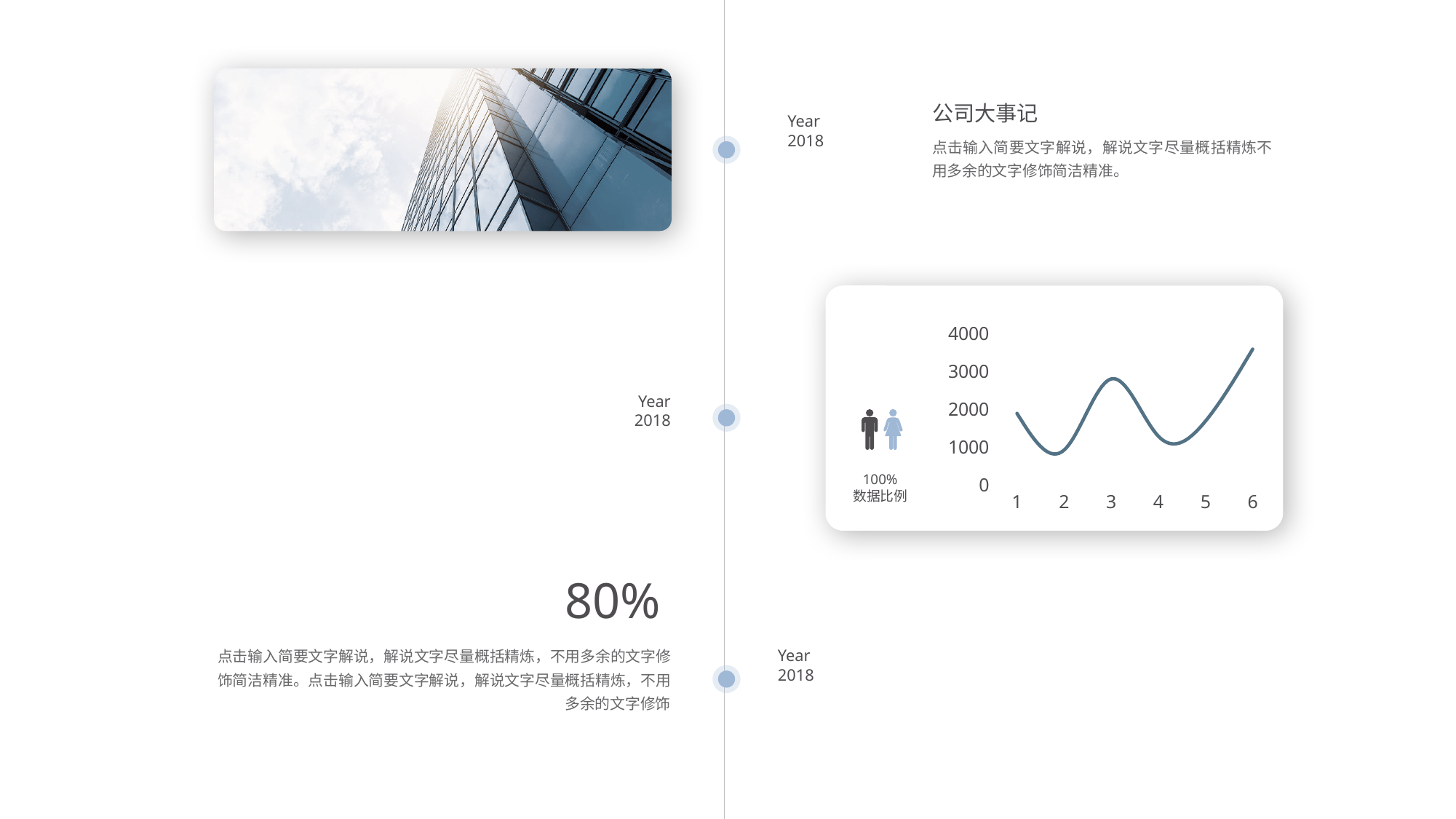
Which has the larger value, x = 1 or x = 2? 1 What kind of chart is shown on the slide? line chart At which x-axis category does the line chart reach its highest value? 6 How many points are plotted along the x axis of the line chart? 6 Is the value at x = 3 greater or less than 2000? greater At which x-axis category does the line chart reach its lowest value? 2 Is the value at x = 6 greater or less than 3000? greater Is the value at x = 6 higher or lower than the value at x = 1? higher What is the highest tick value shown on the y axis of the line chart? 4000 Is the value at x = 1 greater or less than 1000? greater Which has the larger value, x = 3 or x = 5? 3